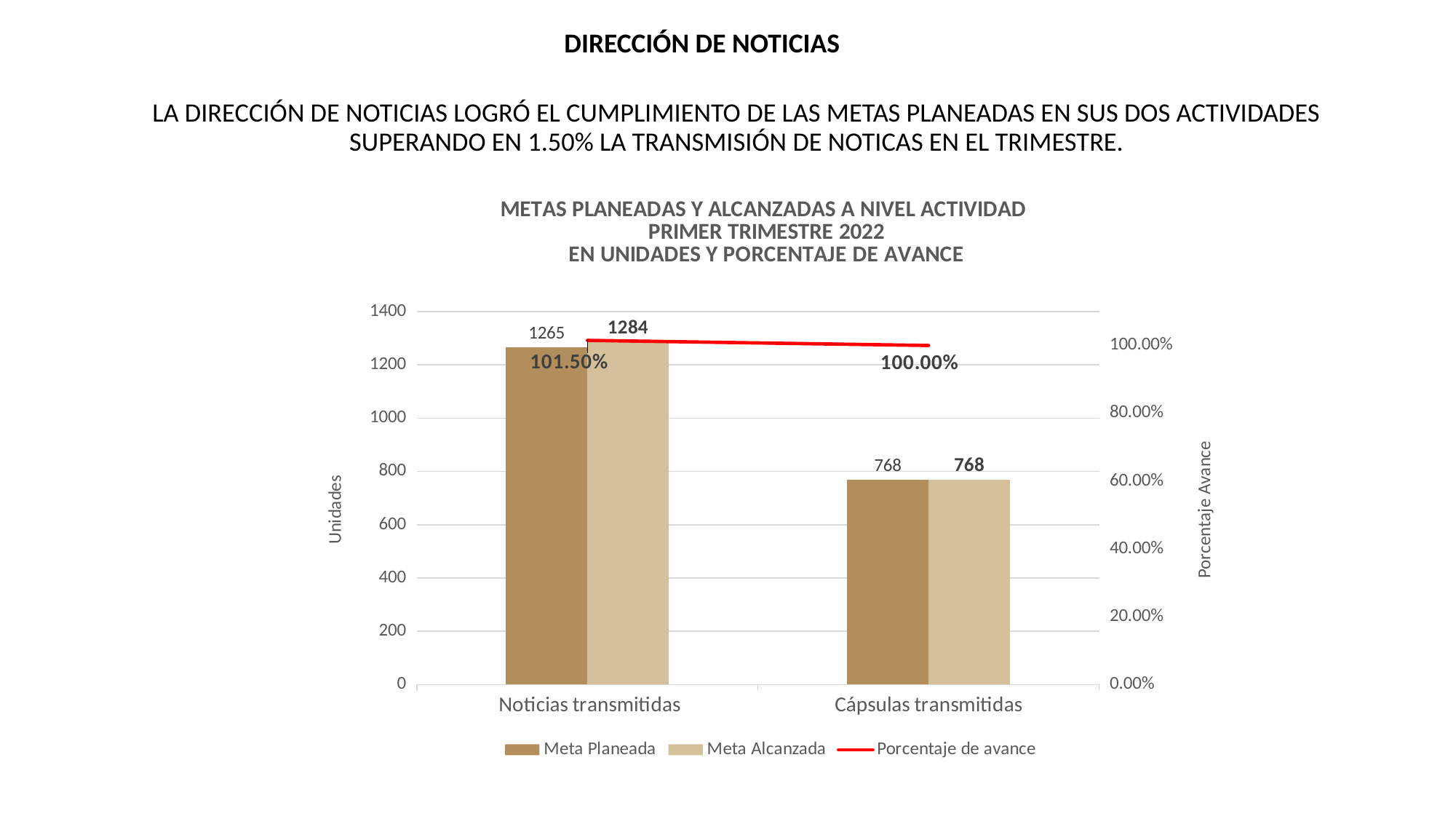
Is the Meta Planeada value for Cápsulas transmitidas greater or less than 800? less What is the Porcentaje de avance for Noticias transmitidas? 101.50% What is the Meta Alcanzada value for Noticias transmitidas? 1284 What is the Porcentaje de avance for Cápsulas transmitidas? 100.00% What is the Meta Planeada value for Noticias transmitidas? 1265 Which category has the higher Meta Alcanzada value? Noticias transmitidas How many series does the legend list? 3 What is the label of the left vertical axis? Unidades What kind of chart is used for the Meta Planeada and Meta Alcanzada series? Bar chart What is the Meta Planeada value for Cápsulas transmitidas? 768 How many categories are shown on the x axis? 2 What is the difference between Meta Alcanzada and Meta Planeada for Noticias transmitidas? 19